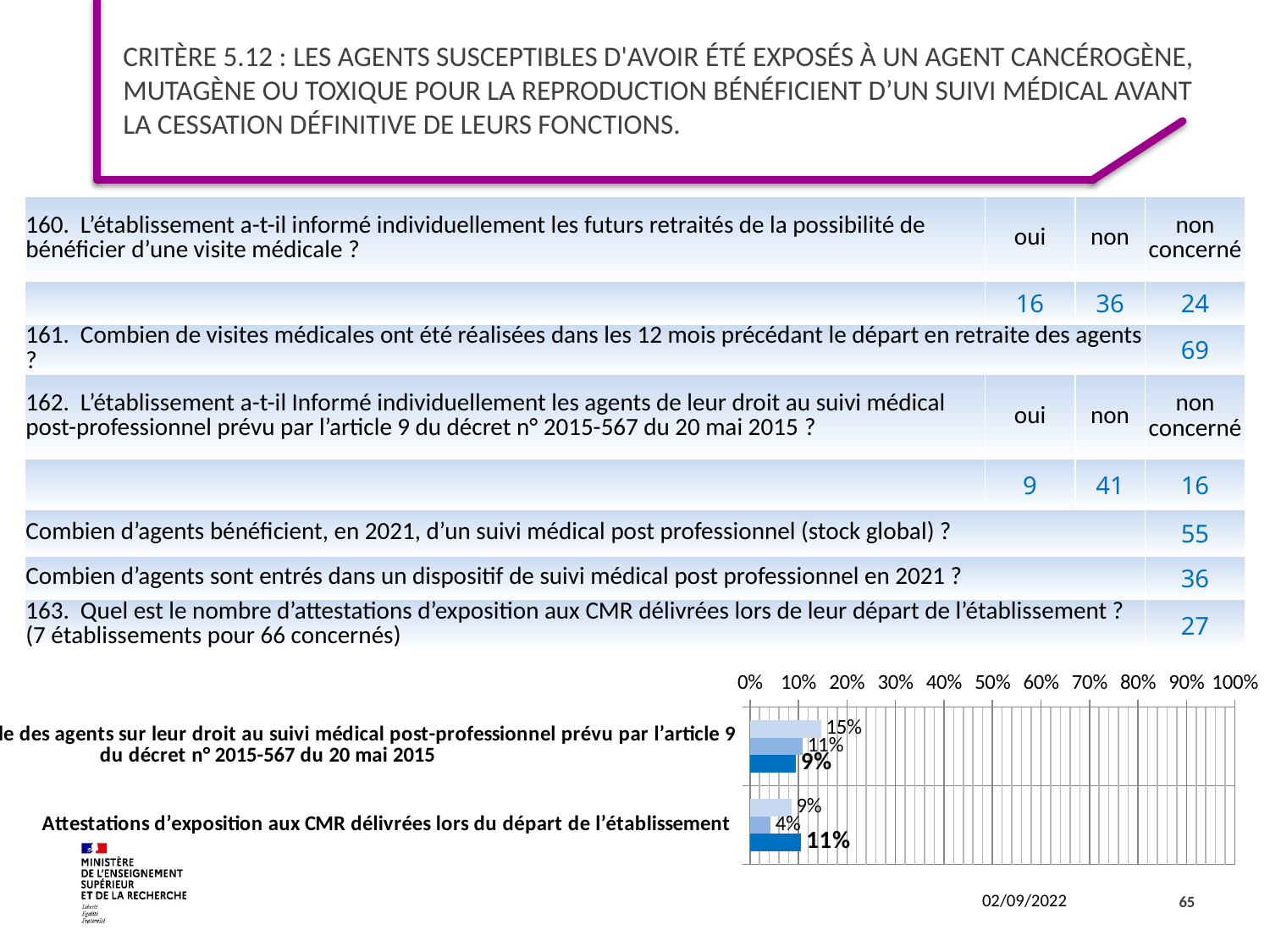
What kind of chart is shown at the bottom of the slide? bar chart In the bar chart, which bar has the lowest value overall? the medium blue (middle) bar of 'Attestations d'exposition aux CMR', 4% In the bar chart, what is the difference between the light blue bar (15%) and the dark blue bar (9%) for the suivi médical post-professionnel category? 6% How many categories does the bar chart show? 2 In the bar chart, what is the value of the medium blue (middle) bar for 'Attestations d'exposition aux CMR délivrées lors du départ de l'établissement'? 4% In the bar chart, which bar has the highest value overall? the light blue (top) bar of the suivi médical post-professionnel category, 15% In the bar chart, what is the value of the light blue (top) bar for the category about the droit au suivi médical post-professionnel (article 9 du décret n° 2015-567)? 15% In the bar chart, what is the value of the light blue (top) bar for 'Attestations d'exposition aux CMR délivrées lors du départ de l'établissement'? 9% In the bar chart, what is the value of the dark blue (bottom) bar for 'Attestations d'exposition aux CMR délivrées lors du départ de l'établissement'? 11% In the bar chart, is the dark blue bar for 'Attestations d'exposition aux CMR' (11%) larger or smaller than the dark blue bar for the suivi médical post-professionnel category (9%)? larger In the bar chart, what is the value of the dark blue (bottom) bar for the category about the droit au suivi médical post-professionnel (article 9 du décret n° 2015-567)? 9% What is the maximum value shown on the x axis of the bar chart? 100%